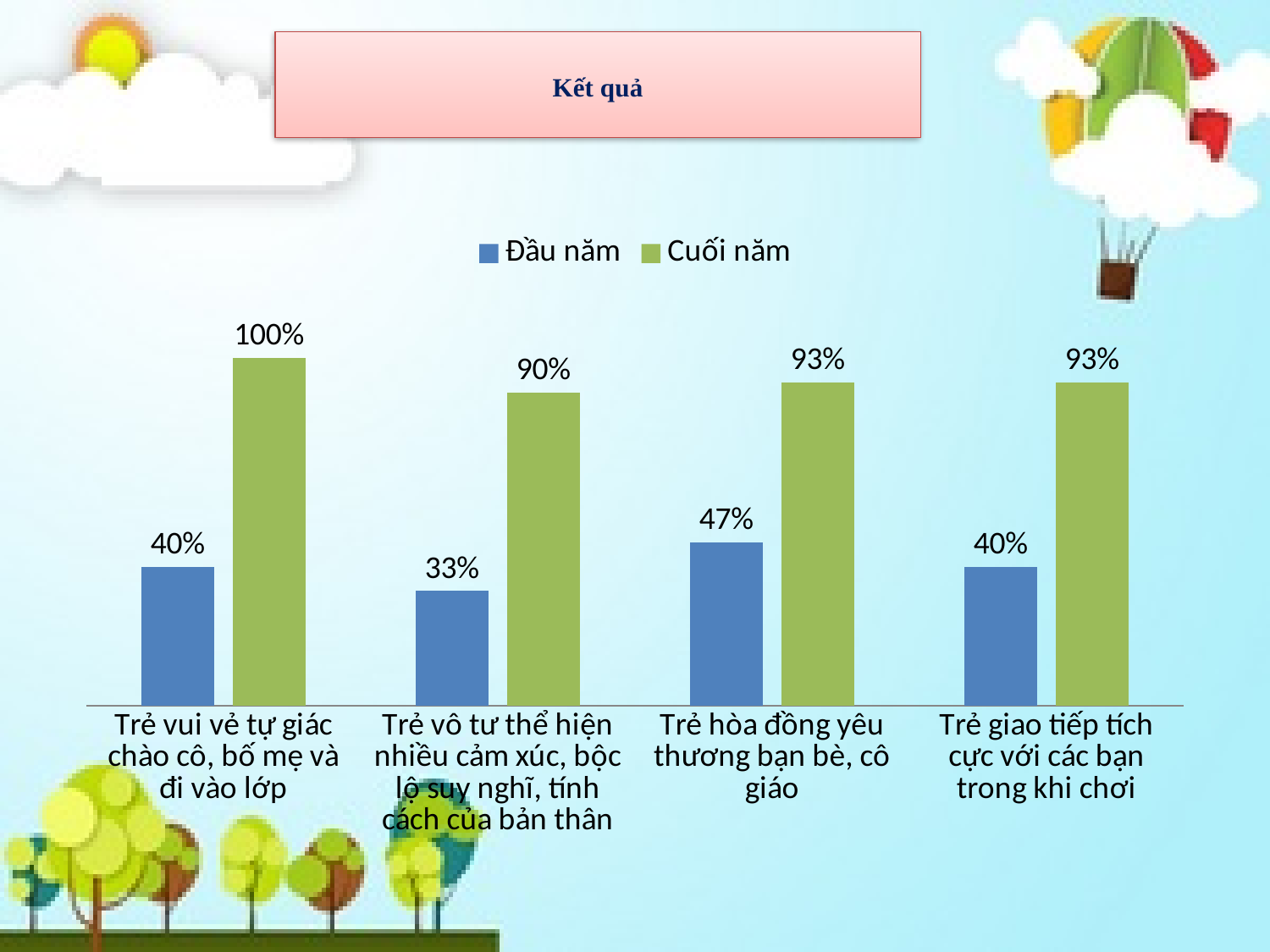
Which category has the lowest "Đầu năm" value? Trẻ vô tư thể hiện nhiều cảm xúc, bộc lộ suy nghĩ, tính cách của bản thân What is the "Cuối năm" value for "Trẻ vô tư thể hiện nhiều cảm xúc, bộc lộ suy nghĩ, tính cách của bản thân"? 90% What is the "Đầu năm" value for "Trẻ vui vẻ tự giác chào cô, bố mẹ và đi vào lớp"? 40% Which is larger: the "Đầu năm" value for "Trẻ hòa đồng yêu thương bạn bè, cô giáo" or the "Đầu năm" value for "Trẻ giao tiếp tích cực với các bạn trong khi chơi"? Trẻ hòa đồng yêu thương bạn bè, cô giáo What kind of chart is shown on the slide? Bar chart Which category has the highest "Cuối năm" value? Trẻ vui vẻ tự giác chào cô, bố mẹ và đi vào lớp What is the "Đầu năm" value for "Trẻ hòa đồng yêu thương bạn bè, cô giáo"? 47% What is the "Cuối năm" value for "Trẻ giao tiếp tích cực với các bạn trong khi chơi"? 93% How many categories are shown on the x axis? 4 What is the difference between the "Cuối năm" and "Đầu năm" values for "Trẻ vui vẻ tự giác chào cô, bố mẹ và đi vào lớp"? 60% How many series does the legend list? 2 What is the difference between the "Cuối năm" and "Đầu năm" values for "Trẻ hòa đồng yêu thương bạn bè, cô giáo"? 46%